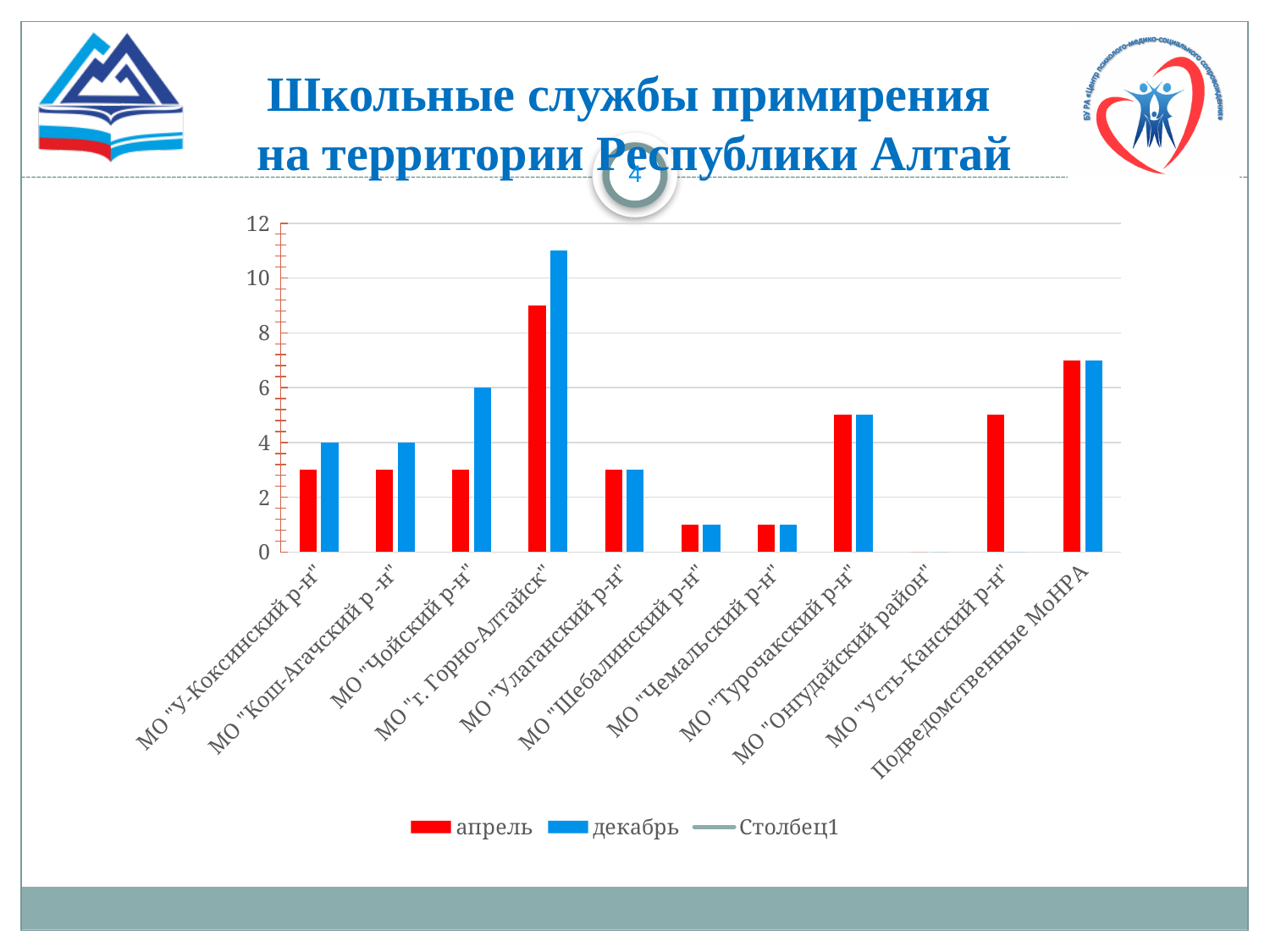
What is the value for декабрь for МО "Чойский р-н"? 6 Which is larger for МО "Чойский р-н": the апрель value or the декабрь value? декабрь What are the names of the series in the legend? апрель, декабрь, Столбец1 How many categories are shown on the x axis? 11 How many series does the legend list? 3 Is the value for апрель for Подведомственные МоНРА greater or less than 6? greater What kind of chart is shown on the slide? bar chart Which category has the highest value for декабрь? МО "г. Горно-Алтайск"